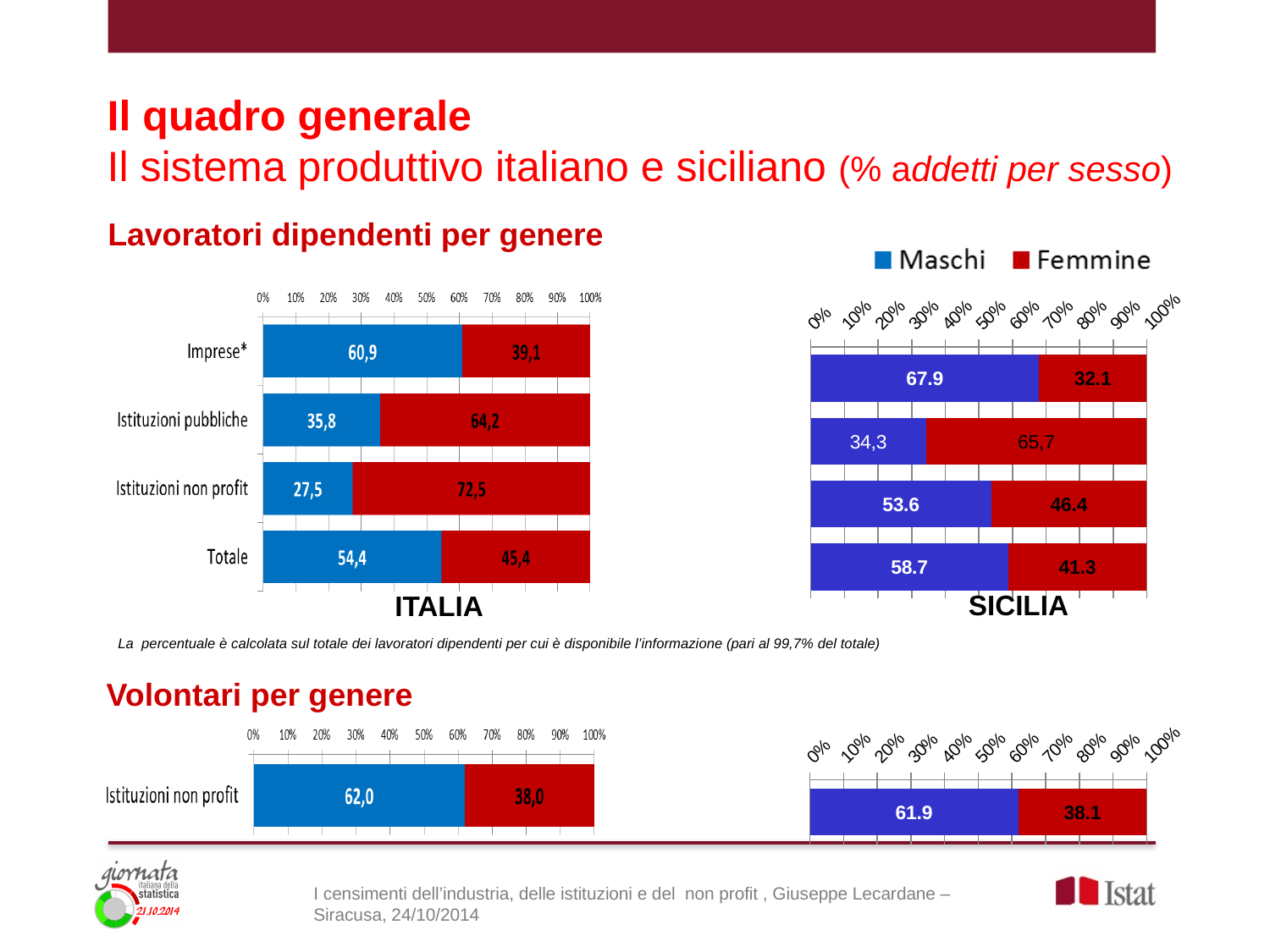
What kind of chart is the SICILIA chart under 'Volontari per genere'? Stacked bar chart In the ITALIA chart under 'Lavoratori dipendenti per genere', what is the Femmine value for Istituzioni non profit? 72,5 In the ITALIA chart under 'Lavoratori dipendenti per genere', what is the difference between the Femmine and Maschi values for Istituzioni pubbliche? 28,4 In the SICILIA chart under 'Lavoratori dipendenti per genere', what is the Maschi value in the top bar? 67.9 In the SICILIA chart under 'Lavoratori dipendenti per genere', is the Maschi value in the second bar from the top greater or less than 40%? less In the ITALIA chart under 'Lavoratori dipendenti per genere', how many categories are shown? 4 How many series does the legend above the SICILIA chart list? 2 In the ITALIA chart under 'Volontari per genere', what is the Femmine value for Istituzioni non profit? 38,0 In the ITALIA chart under 'Lavoratori dipendenti per genere', which category has the highest Maschi share? Imprese* In the ITALIA chart under 'Lavoratori dipendenti per genere', which category has the lowest Maschi share? Istituzioni non profit In the ITALIA chart under 'Lavoratori dipendenti per genere', what is the Maschi value for Imprese*? 60,9 In the SICILIA chart under 'Lavoratori dipendenti per genere', what is the Femmine value in the bottom bar? 41.3